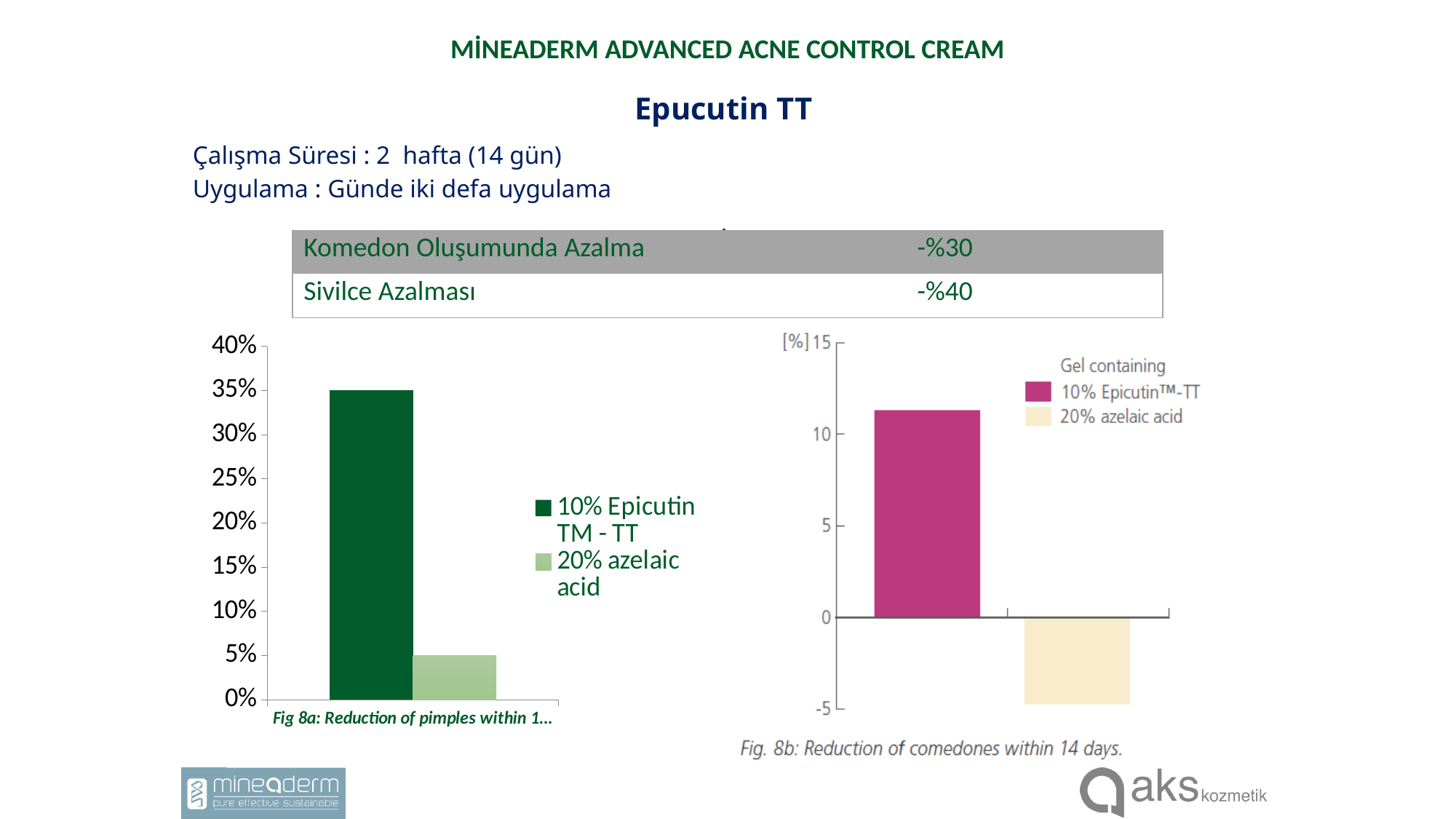
What is the caption of the right chart? Fig. 8b: Reduction of comedones within 14 days. What kind of chart is the left chart (Fig 8a)? Bar chart In the right chart (Fig. 8b), is the value for 10% Epicutin-TT greater or less than 10? greater How many series does the legend of the right chart (Fig. 8b) list? 2 In the right chart (Fig. 8b), is the value for 20% azelaic acid greater or less than 0? less In the left chart (Fig 8a), what is the highest value shown on the vertical axis? 40% In the left chart (Fig 8a), what is the difference between the 10% Epicutin TM - TT value and the 20% azelaic acid value? 30% In the left chart (Fig 8a), what is the value for 10% Epicutin TM - TT? 35% In the left chart (Fig 8a), what is the value for 20% azelaic acid? 5% In the left chart (Fig 8a), which series has the higher value? 10% Epicutin TM - TT In the right chart (Fig. 8b), which series has the larger value, 10% Epicutin-TT or 20% azelaic acid? 10% Epicutin-TT How many series does the legend of the left chart (Fig 8a) list? 2